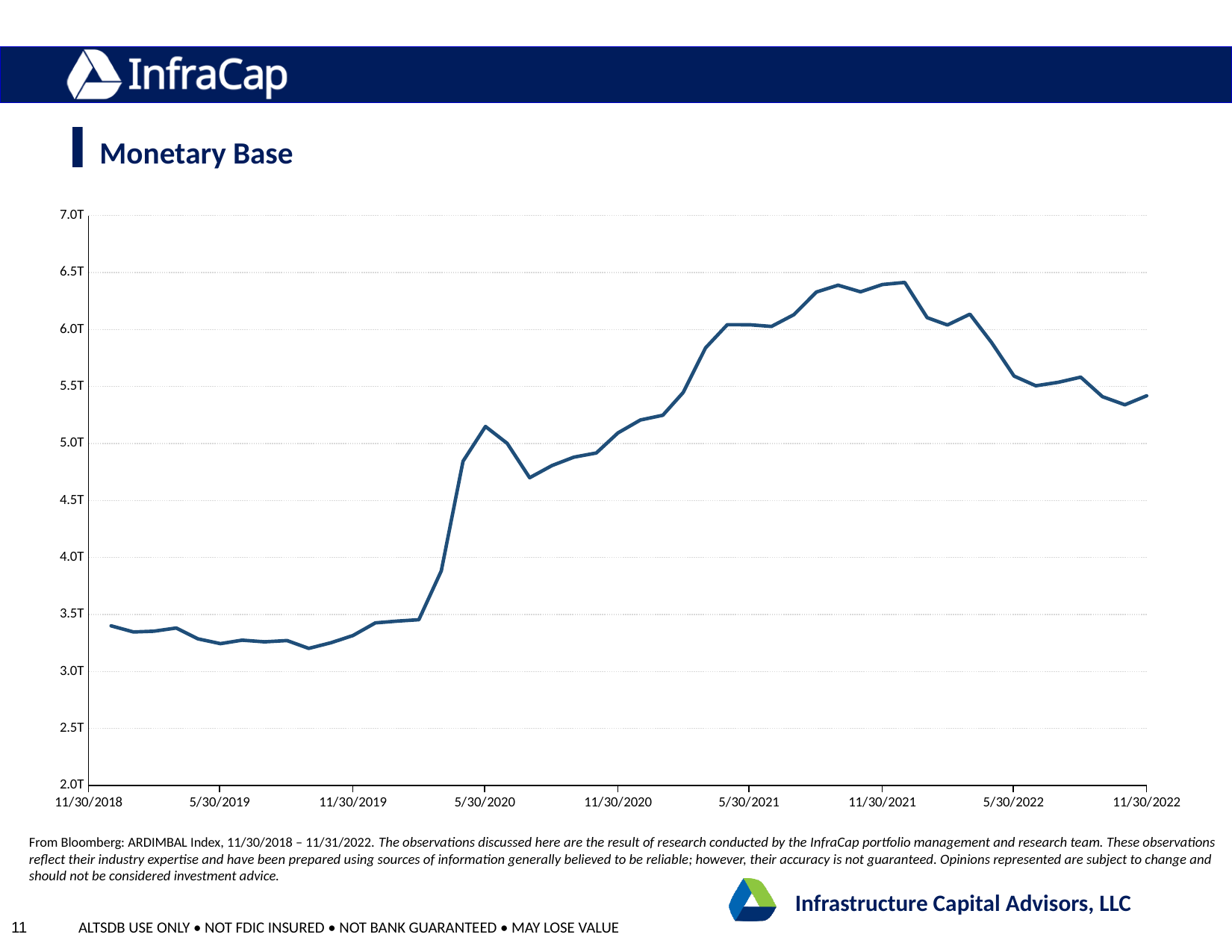
Is the value at 11/30/2018 greater or less than 3.0T? greater Does the line rise or fall between 11/30/2021 and 11/30/2022? fall Is the value at 5/30/2020 greater or less than 5.0T? greater What kind of chart is shown on the slide? line chart Which is larger, the value at 5/30/2021 or the value at 5/30/2022? 5/30/2021 Is the value at 11/30/2021 greater or less than 6.0T? greater How many date labels are shown on the x axis? 9 Which is larger, the value at 11/30/2018 or the value at 11/30/2021? 11/30/2021 What is the title of the chart? Monetary Base How many lines are plotted on the chart? 1